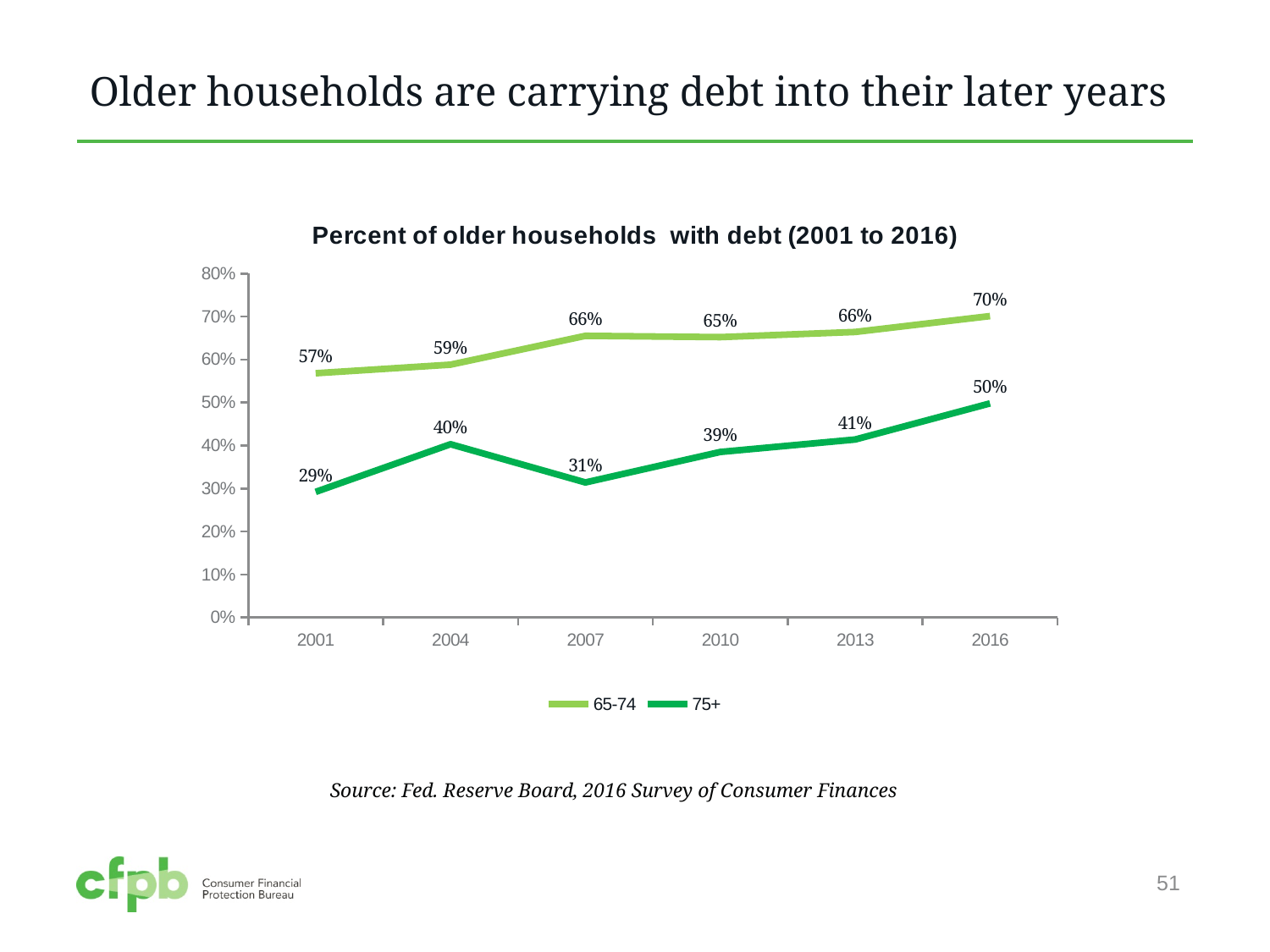
Does the 65-74 series rise or fall from 2001 to 2016? Rise What is the difference between the 65-74 and 75+ values in 2016? 20% What is the title of the chart? Percent of older households with debt (2001 to 2016) What percent of 65-74 households had debt in 2001? 57% What is the value for the 75+ series in 2007? 31% What percent of 75+ households had debt in 2016? 50% How many series does the legend list? 2 How many years are plotted on the x axis? 6 What kind of chart is shown on the slide? Line chart Which series had the larger value in 2010, 65-74 or 75+? 65-74 In which year was the value for the 75+ series lowest? 2001 In which year was the value for the 65-74 series highest? 2016